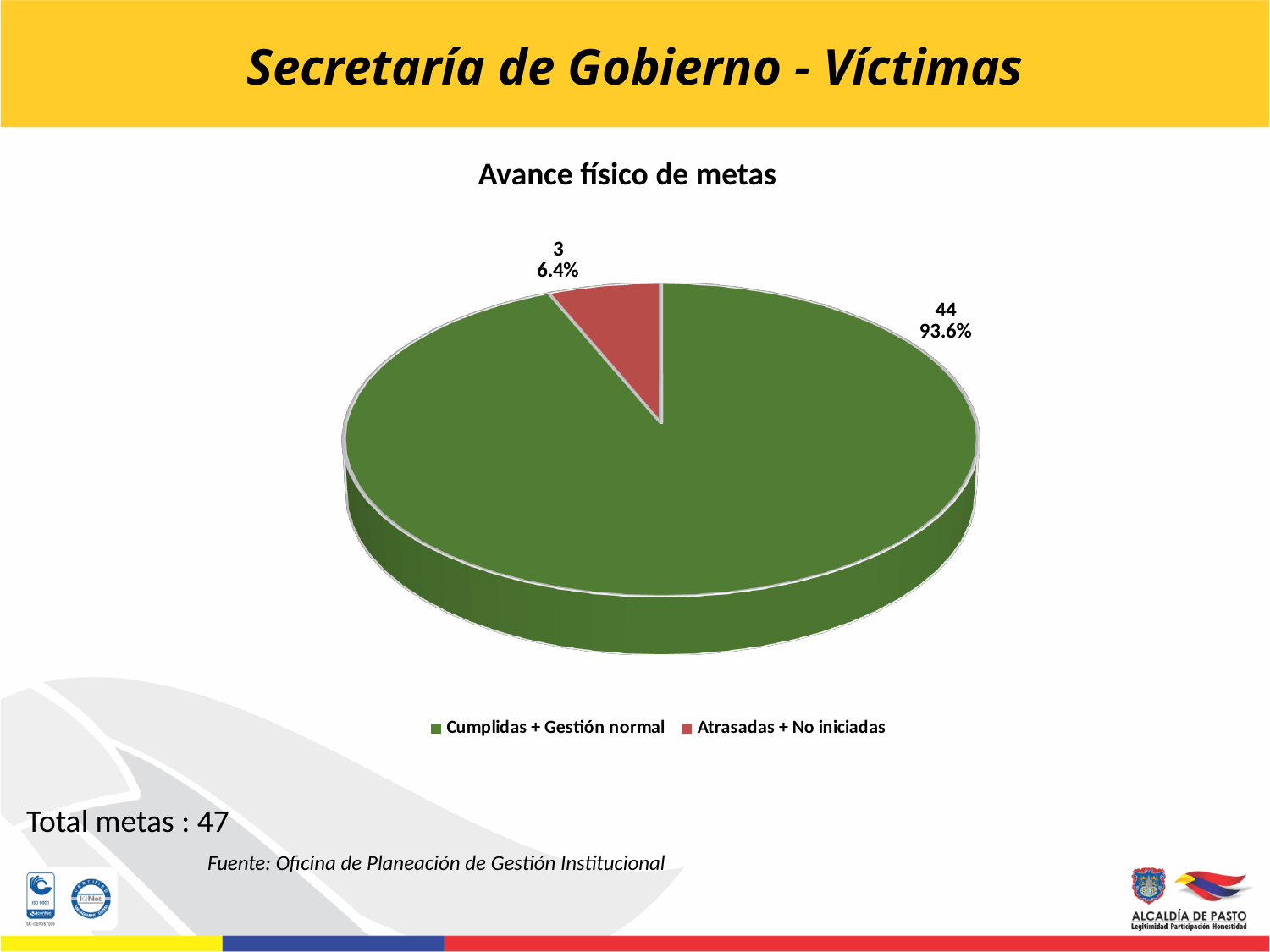
Which category has the largest slice? Cumplidas + Gestión normal What is the value for Cumplidas + Gestión normal? 44 How many series does the legend list? 2 What is the title of the chart? Avance físico de metas What kind of chart is shown on the slide? pie chart Which category has the smallest slice? Atrasadas + No iniciadas Which colour represents Atrasadas + No iniciadas in the legend? red What is the difference between the values for Cumplidas + Gestión normal and Atrasadas + No iniciadas? 41 What is the value for Atrasadas + No iniciadas? 3 What share of the pie does Atrasadas + No iniciadas represent? 6.4% How many slices does the pie chart have? 2 What share of the pie does Cumplidas + Gestión normal represent? 93.6%